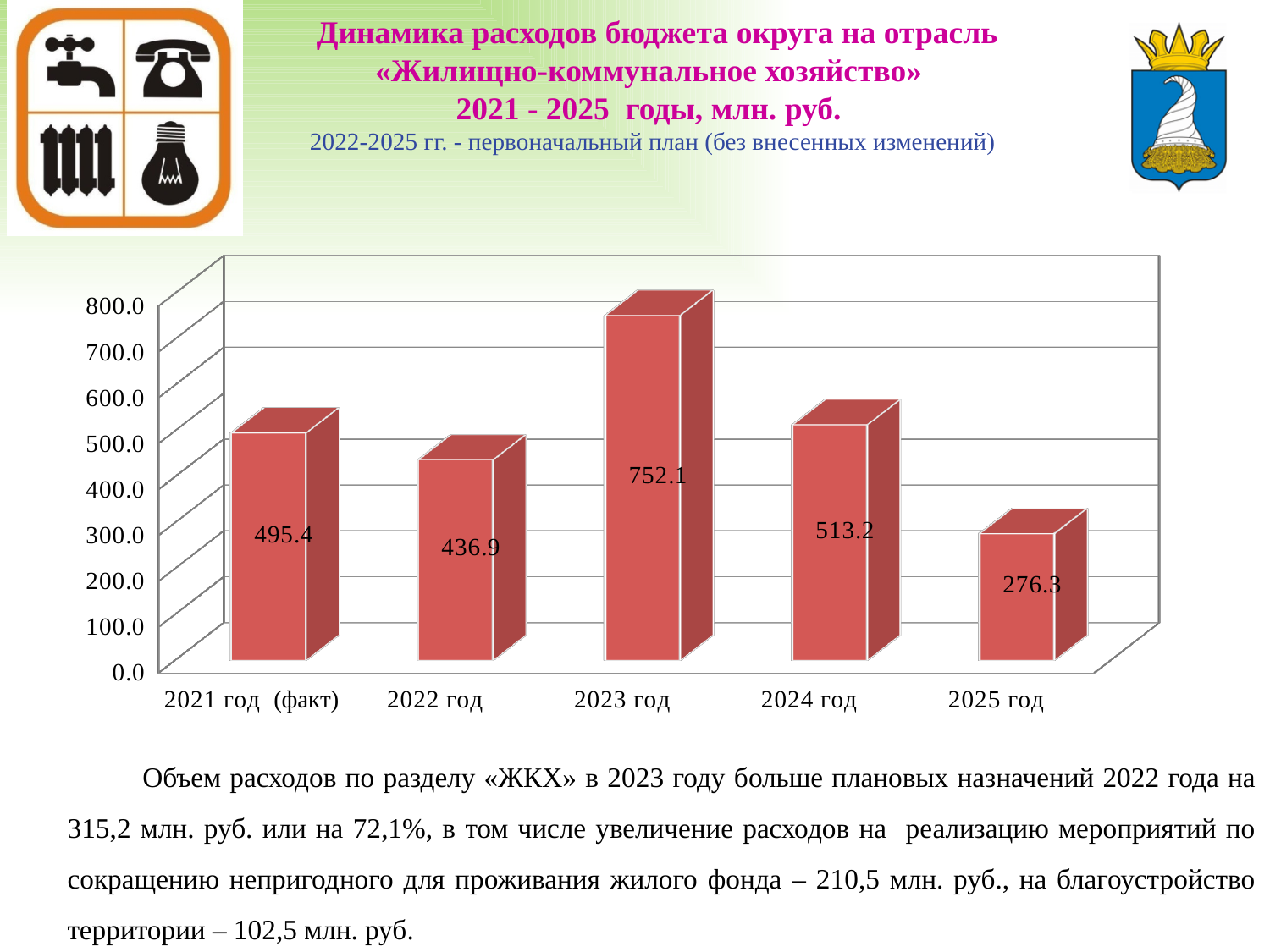
Do the values rise or fall from 2023 год to 2025 год? fall Is the value for 2022 год greater or less than 500.0? less Which year has the lowest value? 2025 год What is the value for 2025 год? 276.3 What is the difference between the values for 2024 год and 2025 год? 236.9 What kind of chart is shown on the slide? bar chart What is the difference between the values for 2023 год and 2022 год? 315.2 How many years are shown on the chart? 5 Which year has the highest value? 2023 год What is the value for 2023 год? 752.1 Which is larger, the value for 2021 год (факт) or the value for 2024 год? 2024 год What is the value for 2021 год (факт)? 495.4